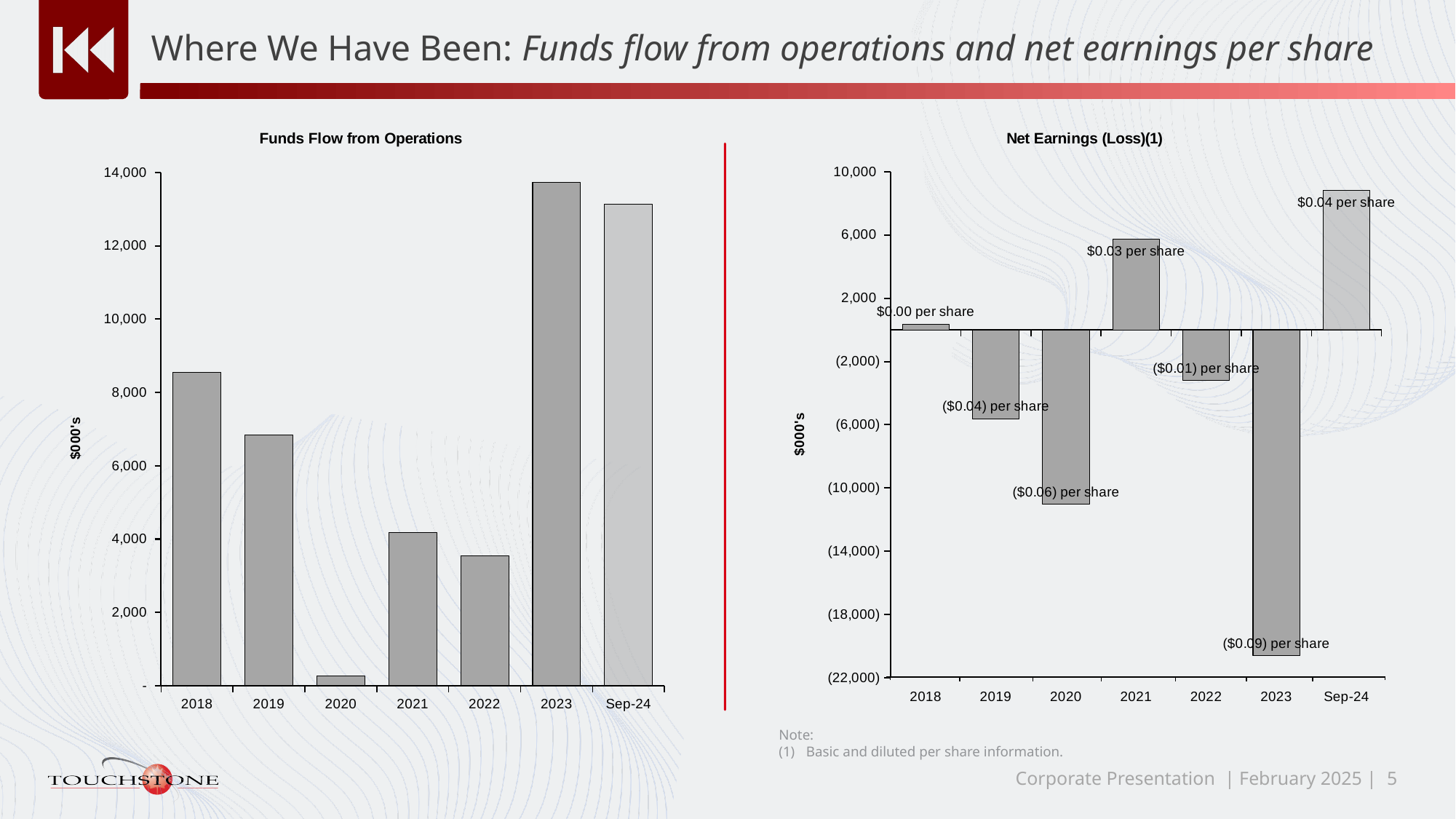
In the Net Earnings (Loss) chart, what is the per share figure labelled for Sep-24? $0.04 per share In the Net Earnings (Loss) chart, is the value for 2020 greater or less than (10,000)? less In the Funds Flow from Operations chart, which is larger, the value for 2019 or the value for 2021? 2019 In the Funds Flow from Operations chart, is the value for 2022 greater or less than 4,000? less How many periods are shown on the x axis of the Funds Flow from Operations chart? 7 What is the y-axis label on the Net Earnings (Loss) chart? $000's In the Funds Flow from Operations chart, is the value for 2018 greater or less than 8,000? greater What kind of chart is the Funds Flow from Operations chart? bar chart In the Net Earnings (Loss) chart, which period has the lowest net earnings? 2023 In the Net Earnings (Loss) chart, what is the per share figure labelled for 2023? ($0.09) per share In the Funds Flow from Operations chart, which period has the highest value? 2023 In the Funds Flow from Operations chart, which period has the lowest value? 2020